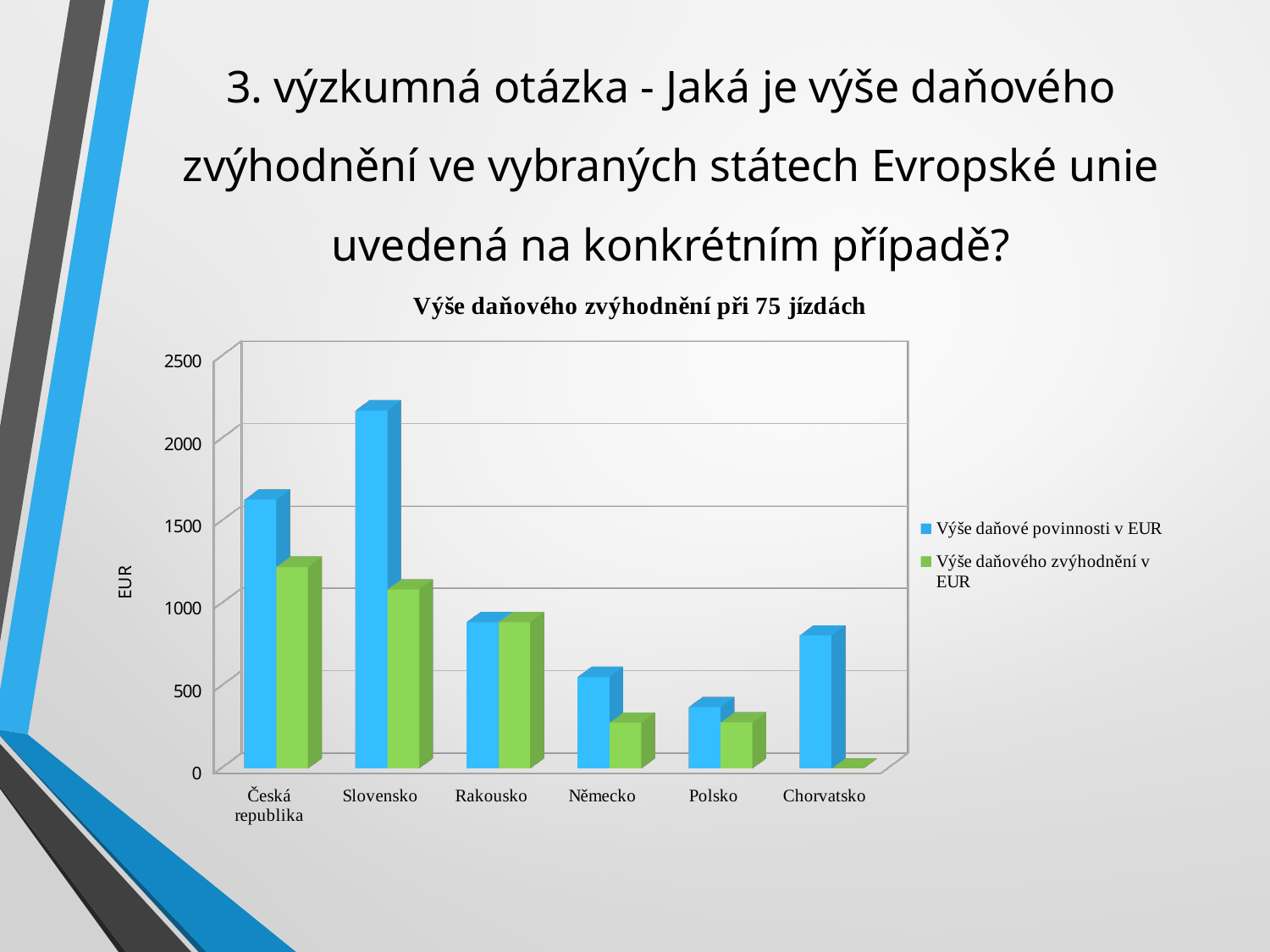
Is the value of Výše daňové povinnosti v EUR for Slovensko greater or less than 2000? greater Is the value of Výše daňové povinnosti v EUR for Polsko greater or less than 500? less Which is larger: Výše daňové povinnosti v EUR for Chorvatsko or for Polsko? Chorvatsko How many countries are shown on the x axis of the chart? 6 What is the title of the chart? Výše daňového zvýhodnění při 75 jízdách Which country has the lowest value for Výše daňové povinnosti v EUR? Polsko Which country has the highest value for Výše daňové povinnosti v EUR? Slovensko Which country has the lowest value for Výše daňového zvýhodnění v EUR? Chorvatsko How many series does the legend list? 2 What label is shown on the vertical axis of the chart? EUR Which country has the highest value for Výše daňového zvýhodnění v EUR? Česká republika What kind of chart is shown on the slide? bar chart